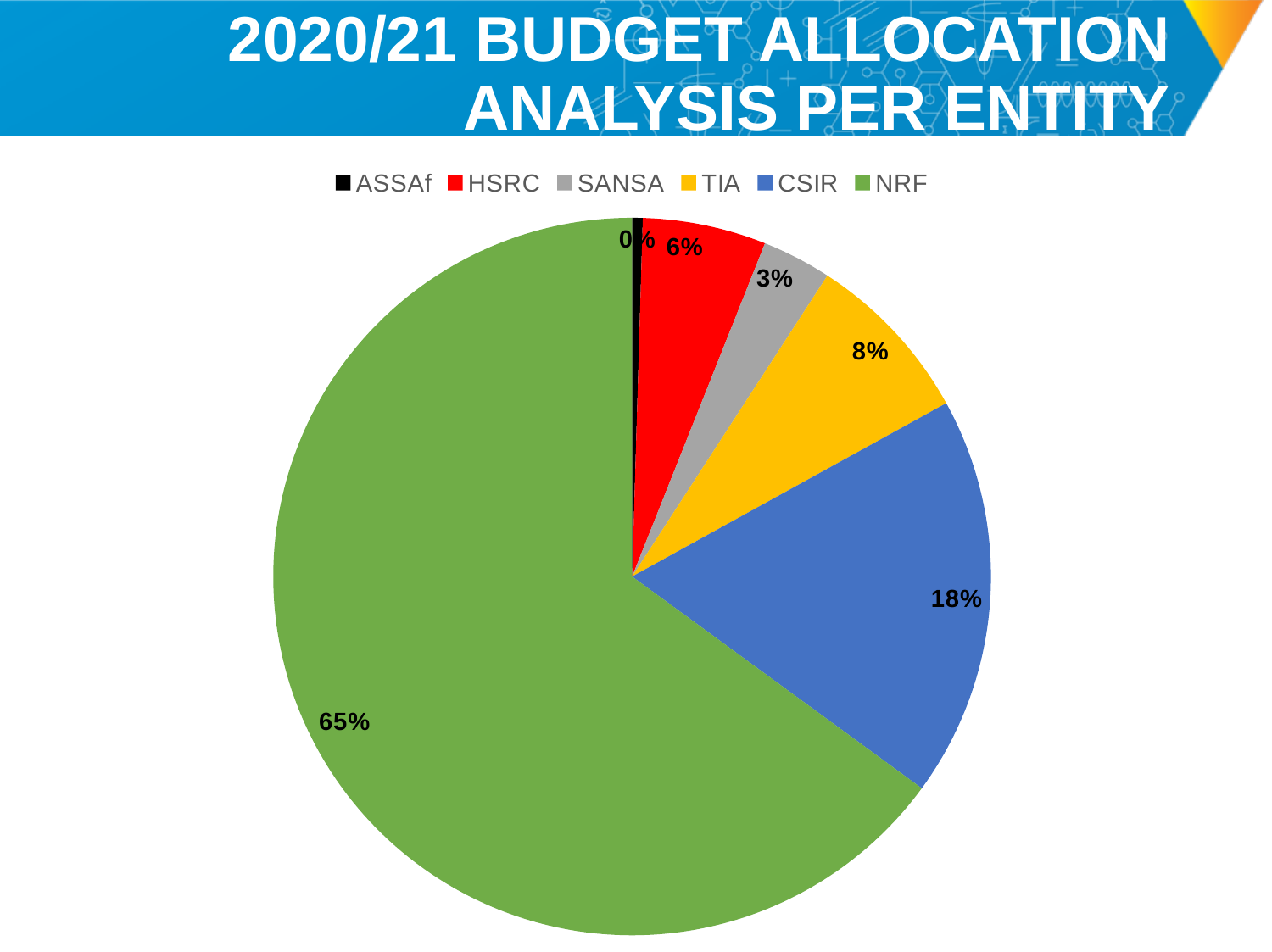
Which entity has the larger share, TIA or HSRC? TIA How many percentage points larger is the NRF share than the CSIR share? 47 What type of chart is shown on the slide? Pie chart How many entities are shown in the pie chart? 6 Which entity receives the smallest share of the budget allocation? ASSAf What share of the budget allocation goes to HSRC? 6% What share of the 2020/21 budget allocation goes to NRF? 65% Which entity receives the largest share of the budget allocation? NRF What colour represents CSIR in the pie chart? Blue What share of the budget allocation goes to SANSA? 3% What share of the budget allocation goes to CSIR? 18% What share of the budget allocation goes to TIA? 8%